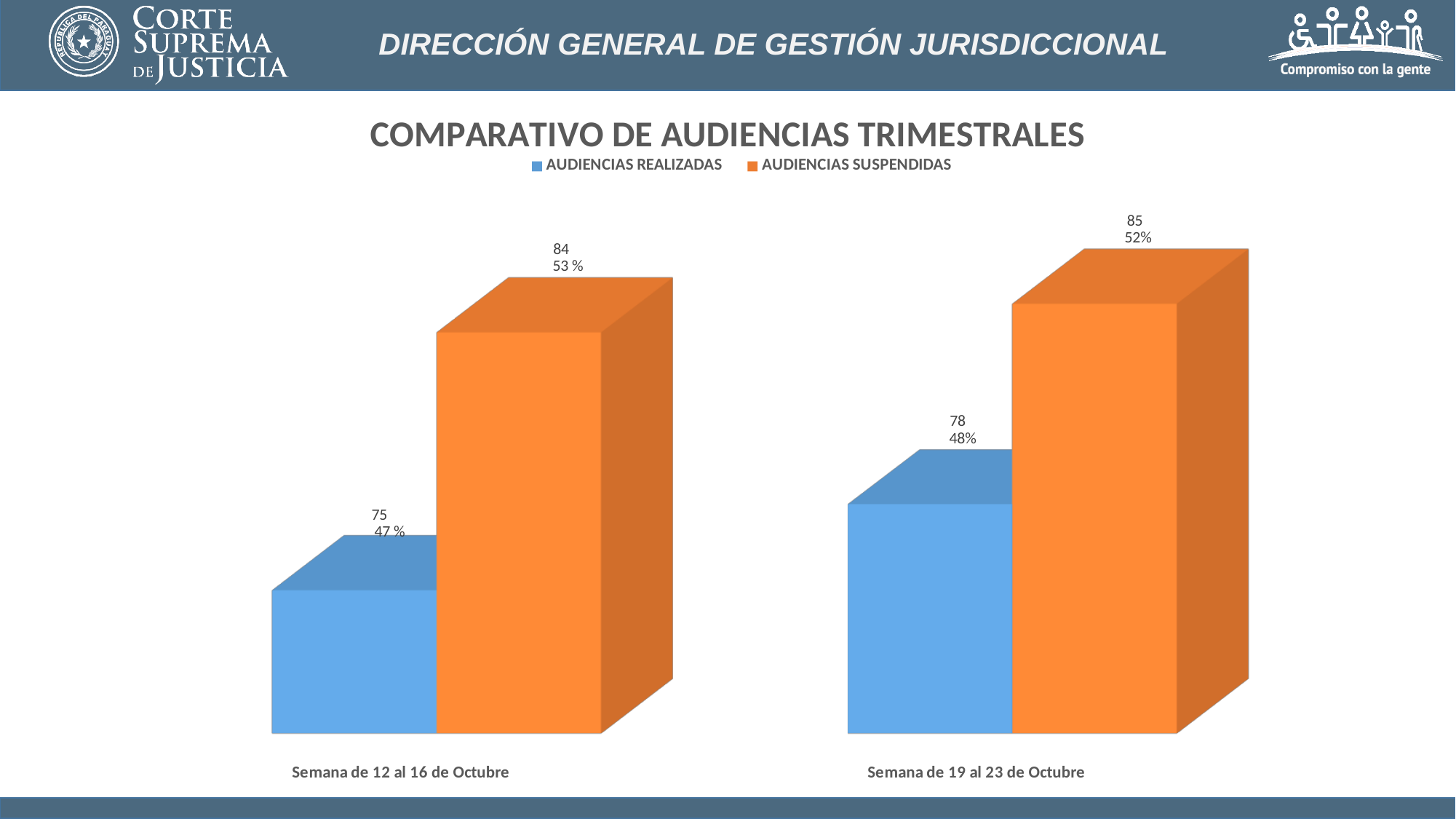
How many week categories are shown on the chart? 2 What percentage is shown for AUDIENCIAS SUSPENDIDAS in Semana de 12 al 16 de Octubre? 53 % Which bar has the lowest value on the chart? AUDIENCIAS REALIZADAS, Semana de 12 al 16 de Octubre What percentage is shown for AUDIENCIAS REALIZADAS in Semana de 19 al 23 de Octubre? 48% Which series has the highest value in Semana de 19 al 23 de Octubre? AUDIENCIAS SUSPENDIDAS What is the value of AUDIENCIAS SUSPENDIDAS for Semana de 19 al 23 de Octubre? 85 Which is larger: AUDIENCIAS REALIZADAS in Semana de 12 al 16 de Octubre or in Semana de 19 al 23 de Octubre? Semana de 19 al 23 de Octubre How many series does the legend list? 2 What kind of chart is shown on the slide? Bar chart What is the value of AUDIENCIAS REALIZADAS for Semana de 12 al 16 de Octubre? 75 What is the title of the chart? COMPARATIVO DE AUDIENCIAS TRIMESTRALES What is the difference between AUDIENCIAS SUSPENDIDAS and AUDIENCIAS REALIZADAS in Semana de 12 al 16 de Octubre? 9